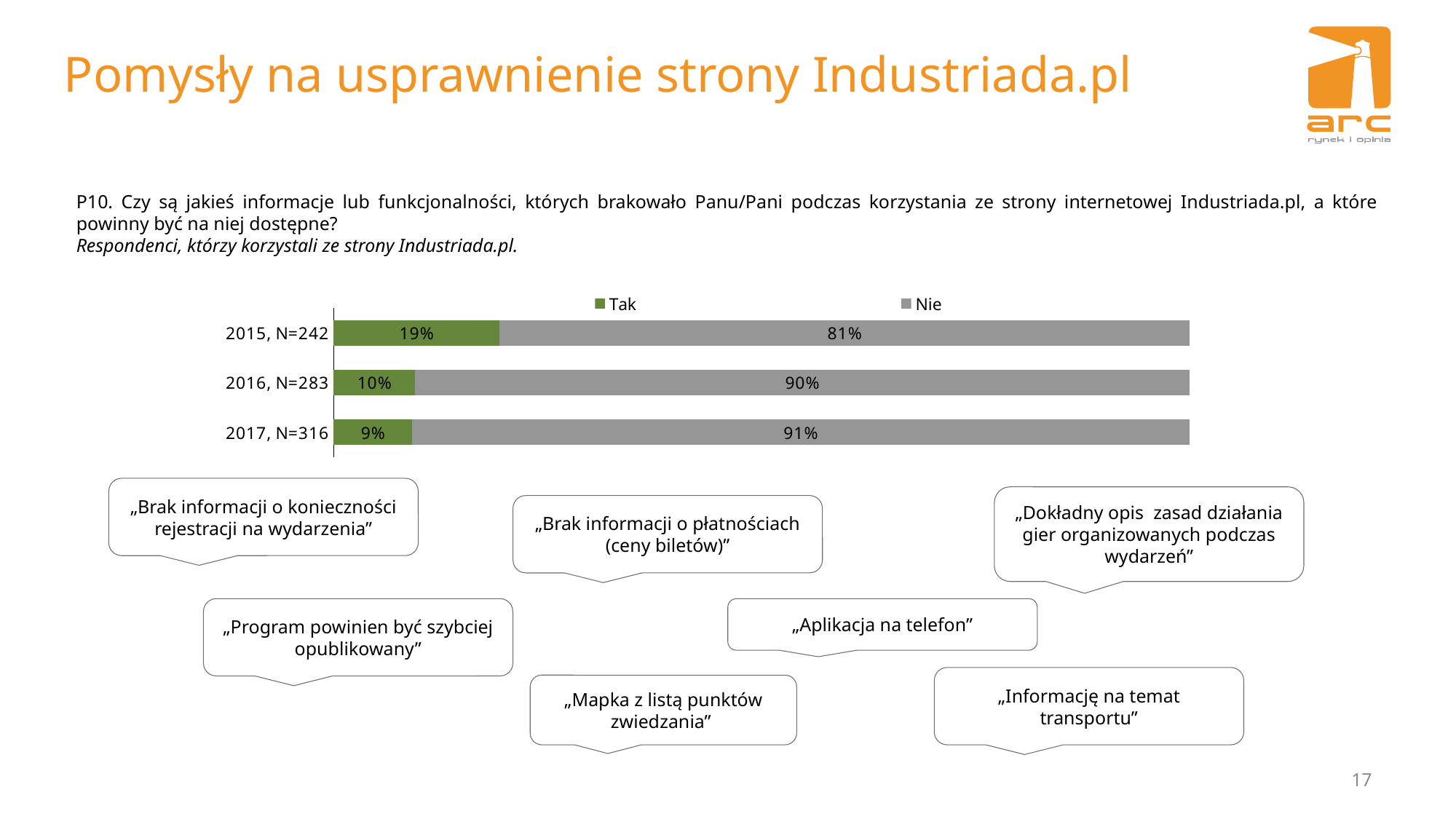
Which is larger: the "Tak" value for 2016, N=283 or for 2017, N=316? 2016, N=283 How many series does the legend list? 2 What kind of chart is shown on the slide? Stacked bar chart What is the "Nie" value for 2017, N=316? 91% What is the "Tak" value for 2015, N=242? 19% What is the difference between the "Tak" values for 2015, N=242 and 2017, N=316? 10 percentage points How many categories (years) are shown on the chart? 3 What is the "Nie" value for 2016, N=283? 90% Does the "Tak" value rise or fall from 2015 to 2017? Fall Which year has the lowest "Nie" value? 2015, N=242 What is the "Tak" value for 2017, N=316? 9% Which year has the highest "Tak" value? 2015, N=242